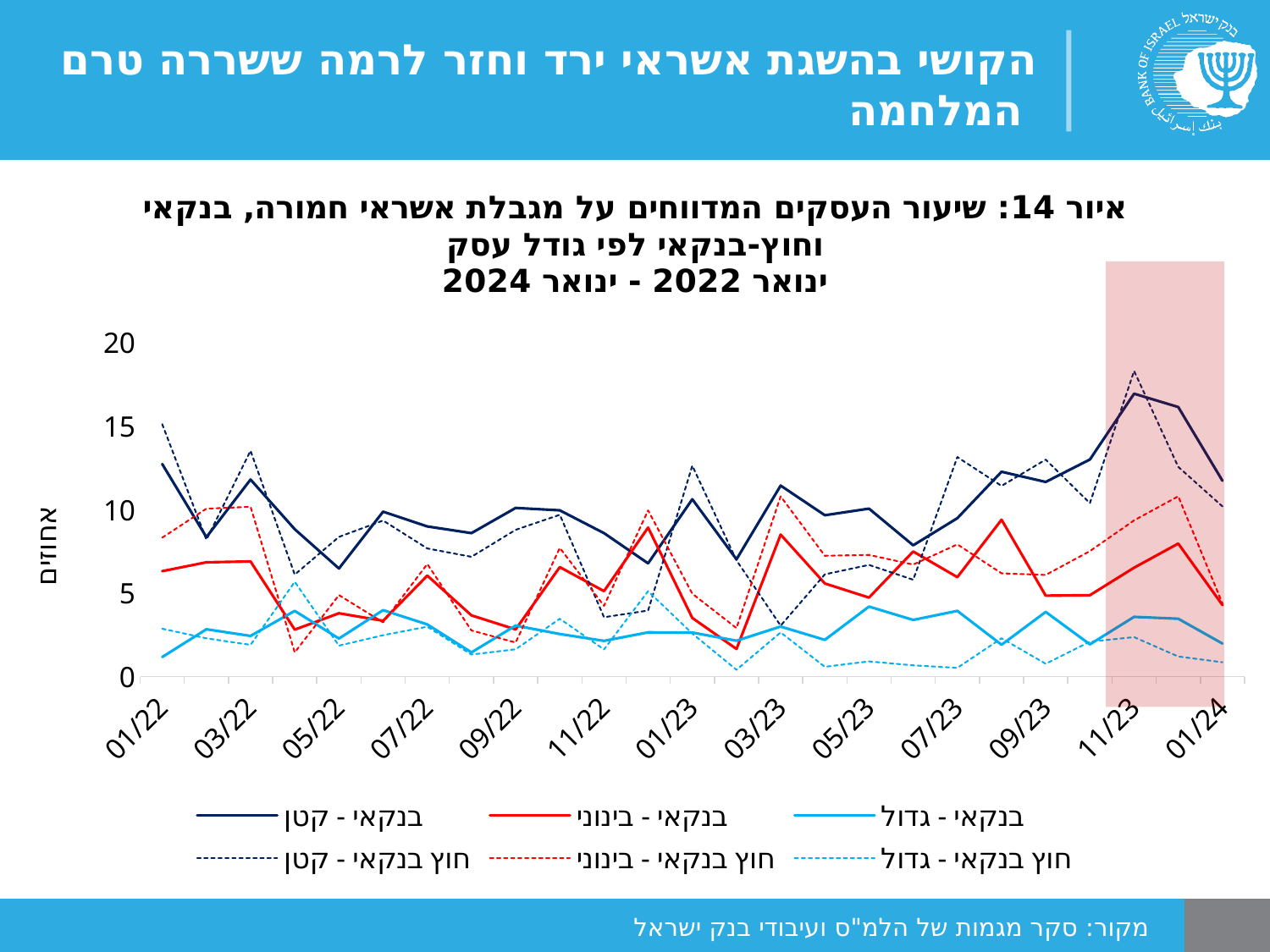
What is the label on the vertical axis? אחוזים At 01/24, which is larger: בנקאי - קטן or בנקאי - גדול? בנקאי - קטן Does the בנקאי - קטן series rise or fall between 09/23 and 11/23? rise Is the value for בנקאי - גדול at 01/22 greater or less than 5? less Is the value for בנקאי - בינוני at 01/22 greater or less than 5? greater Which series has the lowest value at 01/24? חוץ בנקאי - גדול How many date labels are shown on the x axis? 13 Is the value for בנקאי - קטן at 11/23 greater or less than 15? greater How many series does the legend list? 6 Which series are listed in the legend? בנקאי - קטן, בנקאי - בינוני, בנקאי - גדול, חוץ בנקאי - קטן, חוץ בנקאי - בינוני, חוץ בנקאי - גדול Which series has the highest value at 01/22? חוץ בנקאי - קטן What type of chart is shown on the slide? line chart